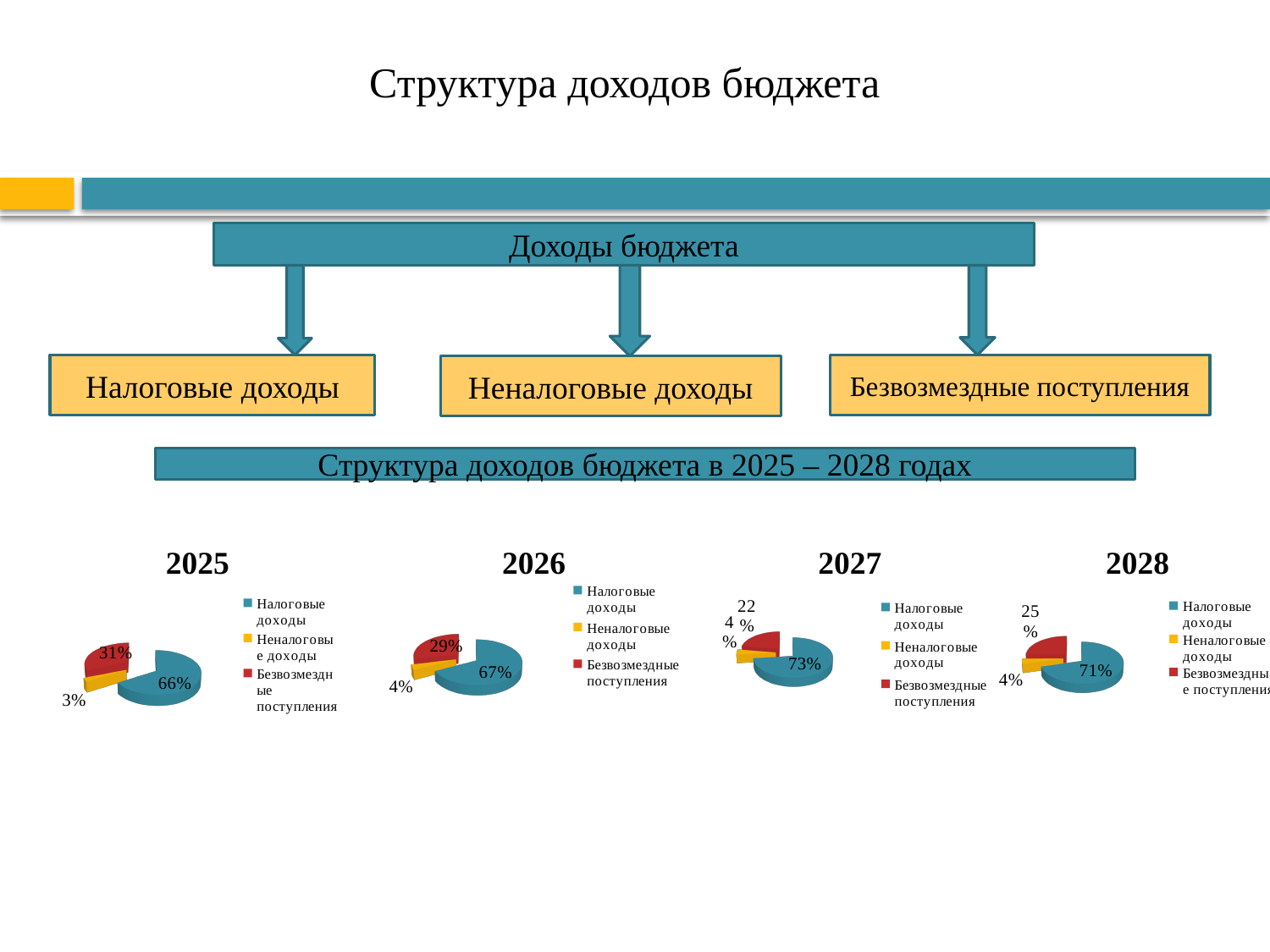
In the 2028 pie chart, what share is Безвозмездные поступления? 25% In the 2027 pie chart, what share is Налоговые доходы? 73% In the 2026 pie chart, which category has the largest share? Налоговые доходы In the 2026 pie chart, what share is Неналоговые доходы? 4% What type of chart is used for the 2026 data? Pie chart In the 2025 pie chart, what colour is the slice for Безвозмездные поступления? Red How many slices does the 2028 pie chart have? 3 In the 2027 pie chart, what is the difference between the shares of Налоговые доходы and Безвозмездные поступления? 51% In the 2025 pie chart, which category has the smallest share? Неналоговые доходы In the 2025 pie chart, what share is Безвозмездные поступления? 31% In the 2025 pie chart, what share is Налоговые доходы? 66% Which is larger: the share of Налоговые доходы in the 2027 pie chart or in the 2028 pie chart? 2027